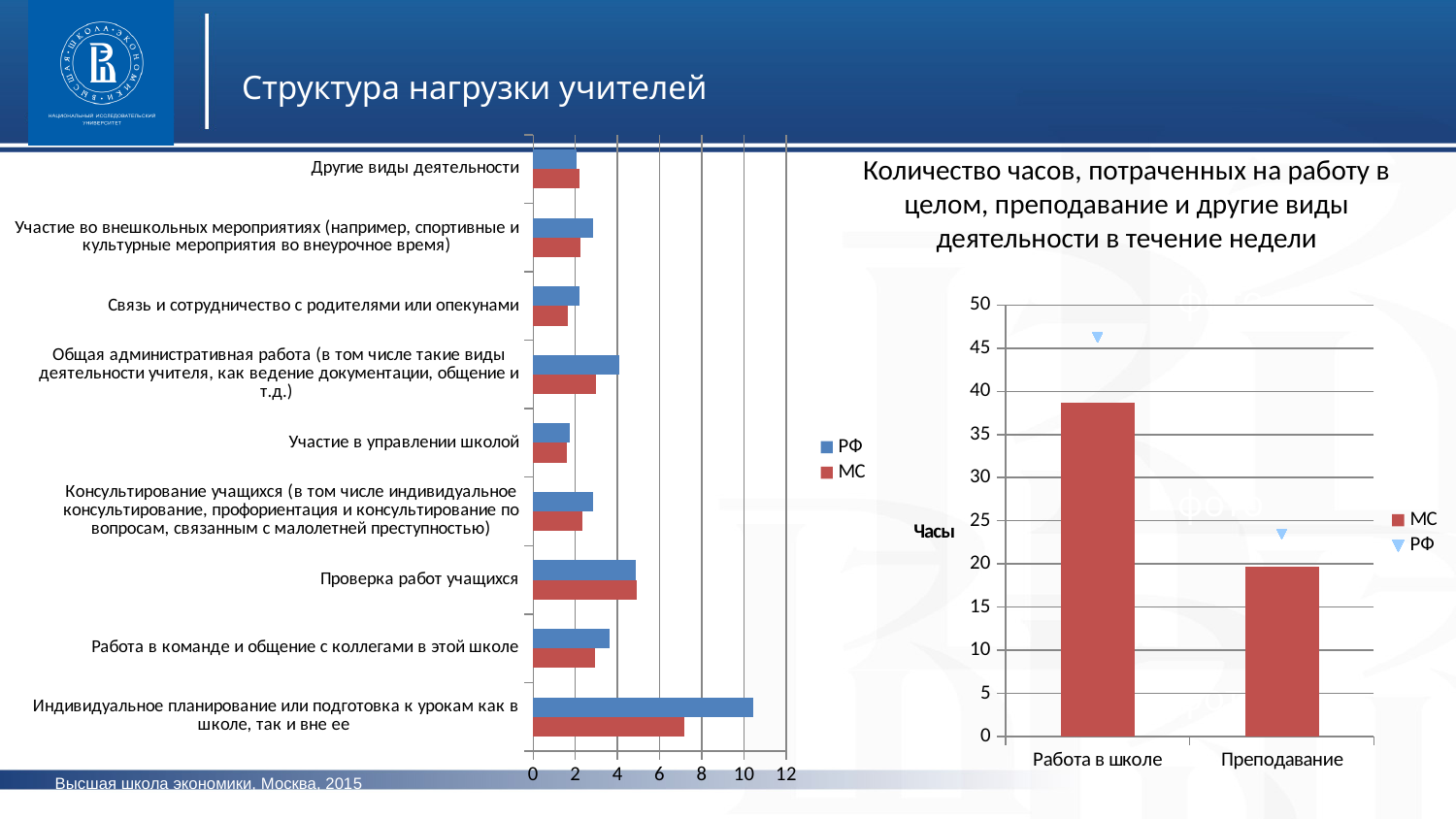
In the left chart, is the РФ value for 'Участие в управлении школой' greater or less than 4? less In the left chart, which category has the highest value for РФ? Индивидуальное планирование или подготовка к урокам как в школе, так и вне ее In the chart on the right, which category has the larger МС value, 'Работа в школе' or 'Преподавание'? Работа в школе In the left chart, for 'Общая административная работа', which series has the larger value, РФ or МС? РФ How many categories are shown on the x axis of the chart titled 'Количество часов, потраченных на работу в целом, преподавание и другие виды деятельности в течение недели'? 2 In the chart on the right, is the МС value for 'Работа в школе' greater or less than 35? greater In the left chart, is the МС value for 'Индивидуальное планирование или подготовка к урокам как в школе, так и вне ее' greater or less than 6? greater What kind of chart is the chart on the left side of the slide? bar chart How many categories does the chart on the left side of the slide show? 9 What is the label on the vertical axis of the chart on the right? Часы How many series does the legend of the left chart list? 2